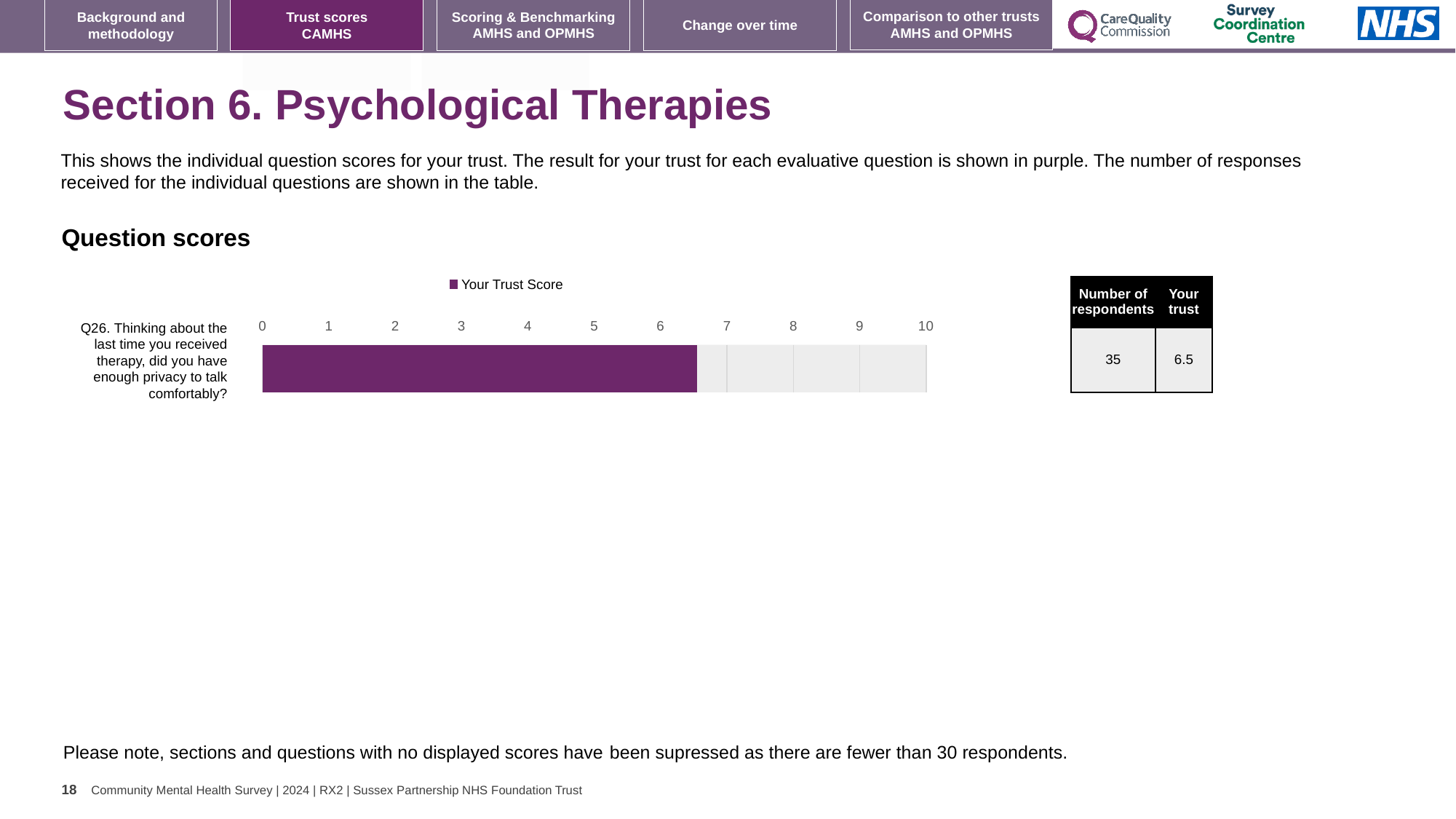
Is the value for Q26 greater or less than 5? greater What is the trust score for Q26 (Thinking about the last time you received therapy, did you have enough privacy to talk comfortably?)? 6.5 How many respondents answered Q26 according to the table next to the chart? 35 How many series does the legend of the Question scores chart list? 1 How many questions (categories) are plotted in the Question scores chart? 1 Is the value for Q26 greater or less than 6? greater Is the value for Q26 greater or less than 7? less What is the maximum value shown on the chart's axis? 10 What kind of chart is used to show the question scores? Bar chart What is the name of the series shown in the chart legend? Your Trust Score